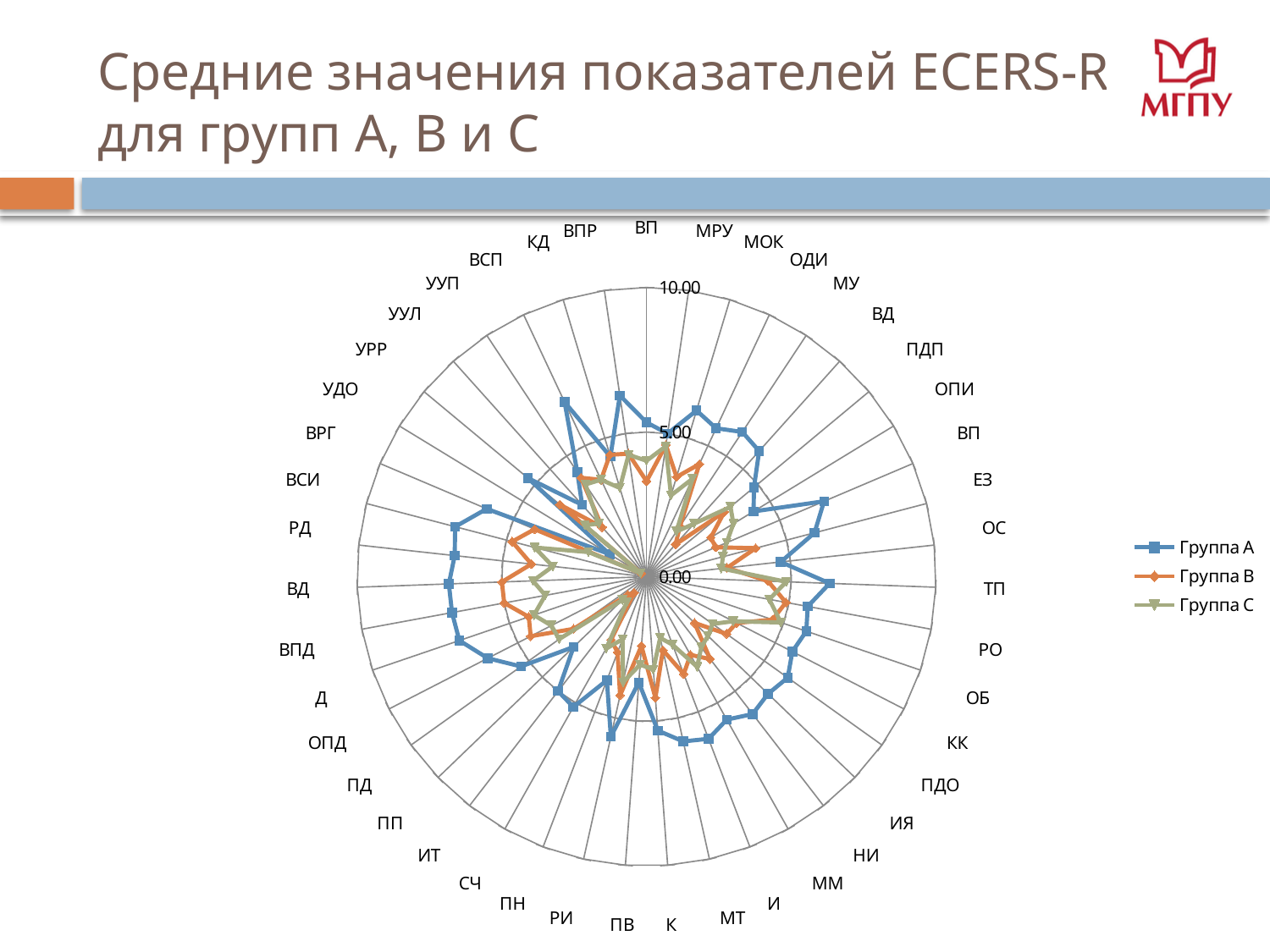
Is the value for Группа A at РД greater or less than 5.00? greater What are the names of the series in the legend? Группа A, Группа B, Группа C Is the value for Группа A at ТП greater or less than 5.00? greater Is the value for Группа A at ТП greater or less than 10.00? less How many series does the legend list? 3 At РД, which series has the larger value, Группа A or Группа C? Группа A At ТП, which series has the larger value, Группа A or Группа C? Группа A What is the title of the chart on the slide? Средние значения показателей ECERS-R для групп A, B и C What kind of chart is shown on the slide? Radar chart Which series has the highest values overall across the chart? Группа A